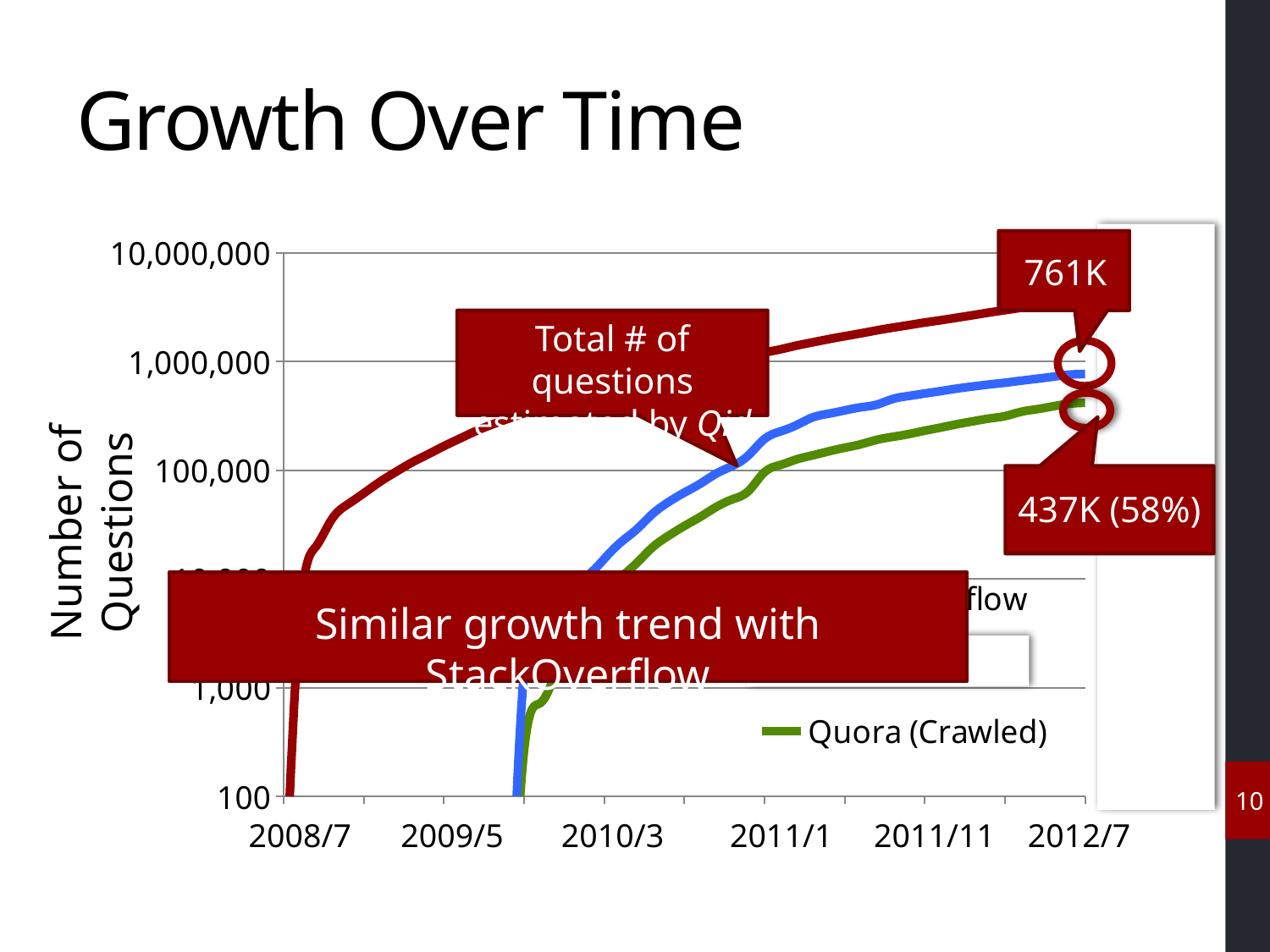
What is the title of the chart on the slide? Growth Over Time What kind of chart is shown on the slide? line chart Do the lines rise or fall over time along the x axis? rise What is the label on the vertical axis of the chart? Number of Questions Is the value of the blue line at 2011/11 greater or less than 1,000,000? less Which line reaches the highest value at 2012/7? the dark red line At 2012/7, which is higher: the blue line or the green line? the blue line How many date labels are shown on the x axis? 6 Is the value of the green line at 2011/11 greater or less than 100,000? greater What value does the callout at the end of the blue line show? 761K What value does the callout at the end of the green line show? 437K (58%) Is the value of the dark red line at 2012/7 greater or less than 1,000,000? greater